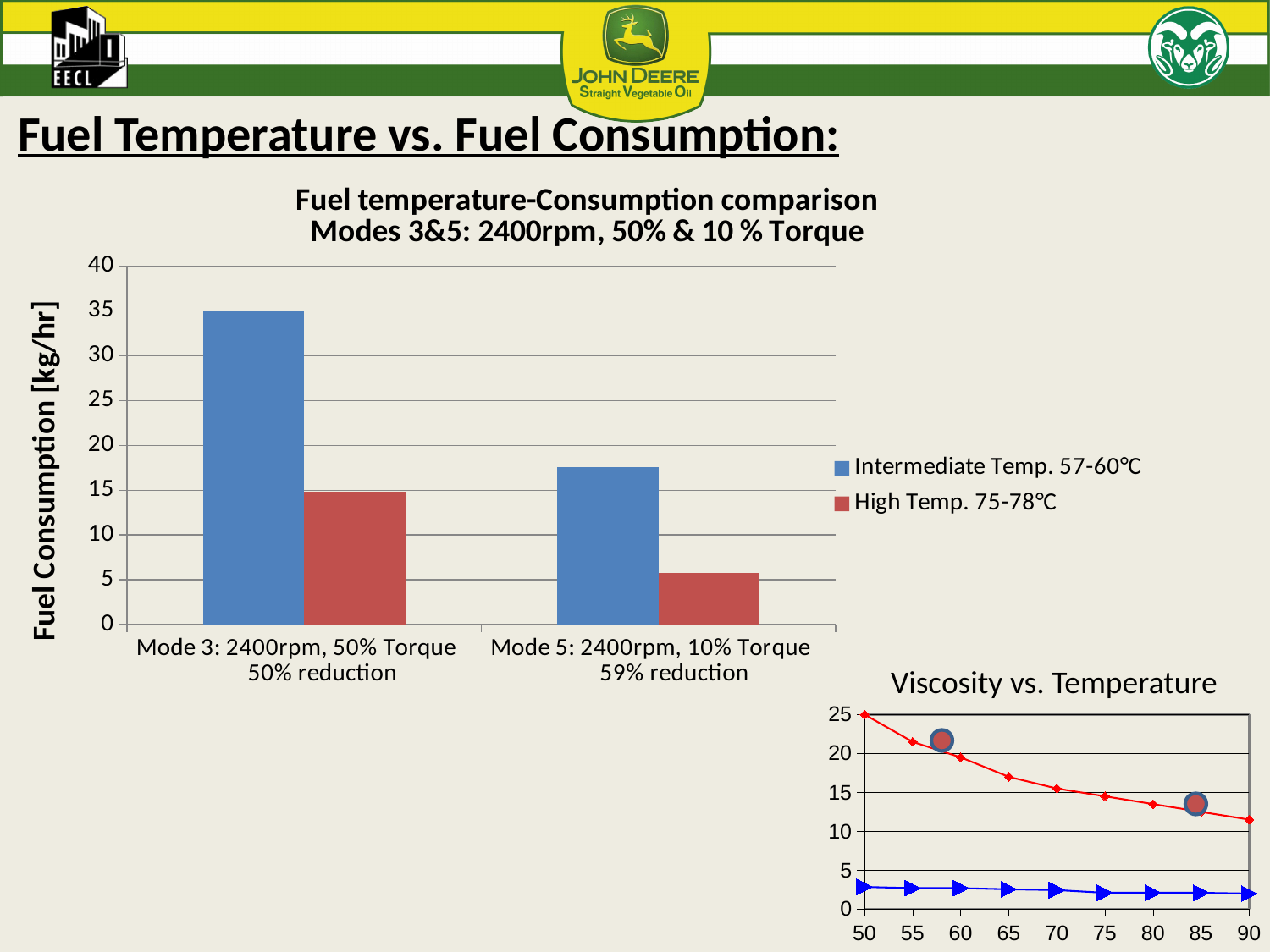
In the 'Fuel temperature-Consumption comparison' chart, what is the label of the y axis? Fuel Consumption [kg/hr] In the 'Fuel temperature-Consumption comparison' chart, is the Intermediate Temp. 57-60℃ value for Mode 5 greater or less than 15? greater What kind of chart is the 'Viscosity vs. Temperature' chart? line chart In the 'Fuel temperature-Consumption comparison' chart, for Mode 3, which series has the larger value: Intermediate Temp. 57-60℃ or High Temp. 75-78℃? Intermediate Temp. 57-60℃ What kind of chart is the 'Fuel temperature-Consumption comparison' chart? bar chart In the 'Fuel temperature-Consumption comparison' chart, how many series does the legend list? 2 In the 'Fuel temperature-Consumption comparison' chart, is the High Temp. 75-78℃ value for Mode 5 greater or less than 10? less In the 'Fuel temperature-Consumption comparison' chart, which category has the higher Intermediate Temp. 57-60℃ value? Mode 3: 2400rpm, 50% Torque In the 'Fuel temperature-Consumption comparison' chart, how many categories are shown on the x axis? 2 In the 'Fuel temperature-Consumption comparison' chart, is the Intermediate Temp. 57-60℃ value for Mode 3 greater or less than 30? greater In the 'Viscosity vs. Temperature' chart, does the red line rise or fall as temperature increases from 50 to 90? fall